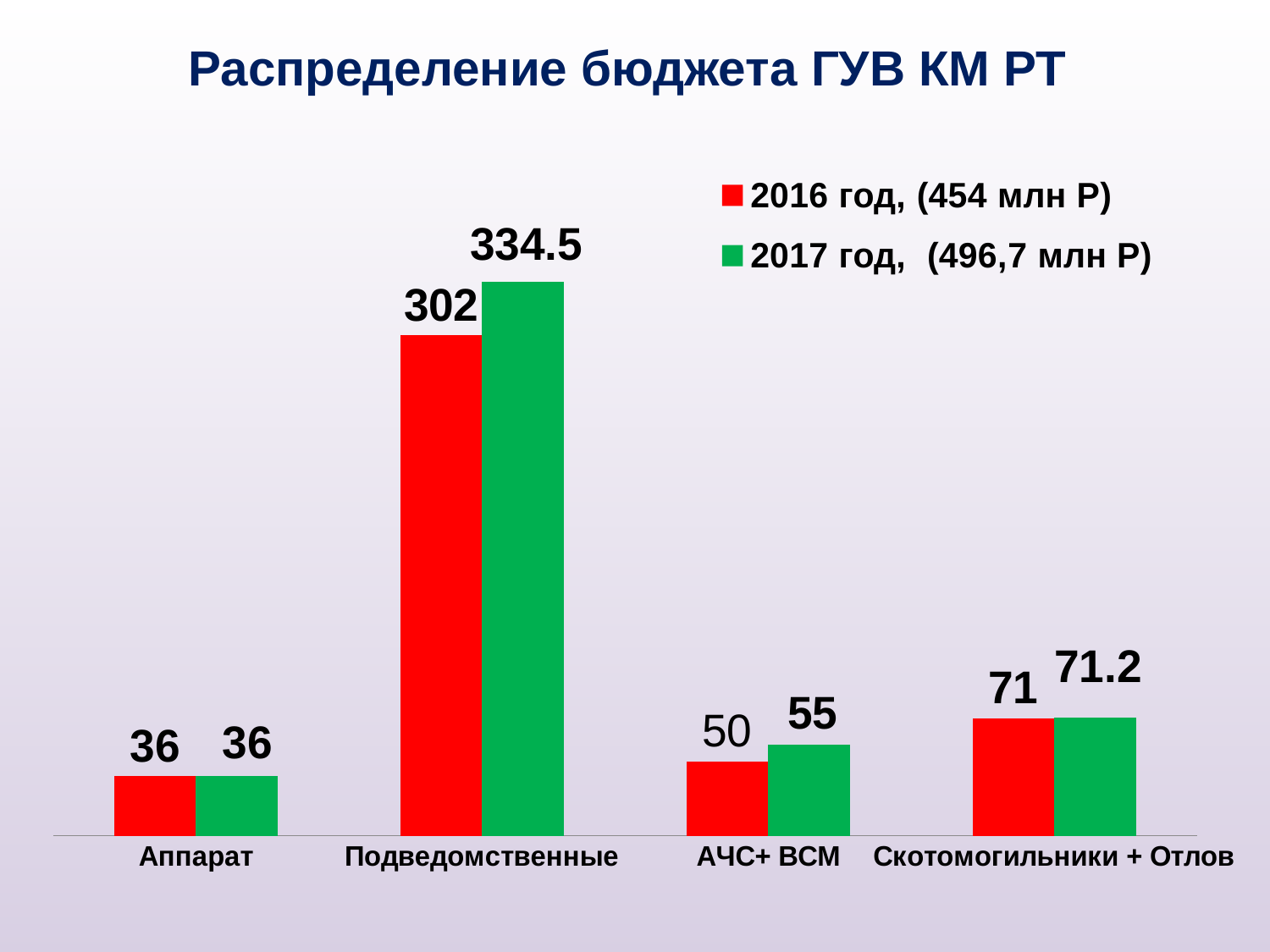
What is the value for Скотомогильники + Отлов in the 2016 год series? 71 How many categories are shown on the x axis? 4 Which category has the highest value in the 2017 год series? Подведомственные Which is larger: the 2016 год value for Скотомогильники + Отлов or the 2017 год value for АЧС+ ВСМ? 2016 год value for Скотомогильники + Отлов What is the value for АЧС+ ВСМ in the 2017 год series? 55 What kind of chart is shown on the slide? Bar chart What is the value for Подведомственные in the 2017 год series? 334.5 Which category has the lowest value in the 2016 год series? Аппарат What is the difference between the 2017 год and 2016 год values for АЧС+ ВСМ? 5 What is the value for Подведомственные in the 2016 год series? 302 What is the difference between the 2017 год and 2016 год values for Подведомственные? 32.5 How many series does the legend list? 2